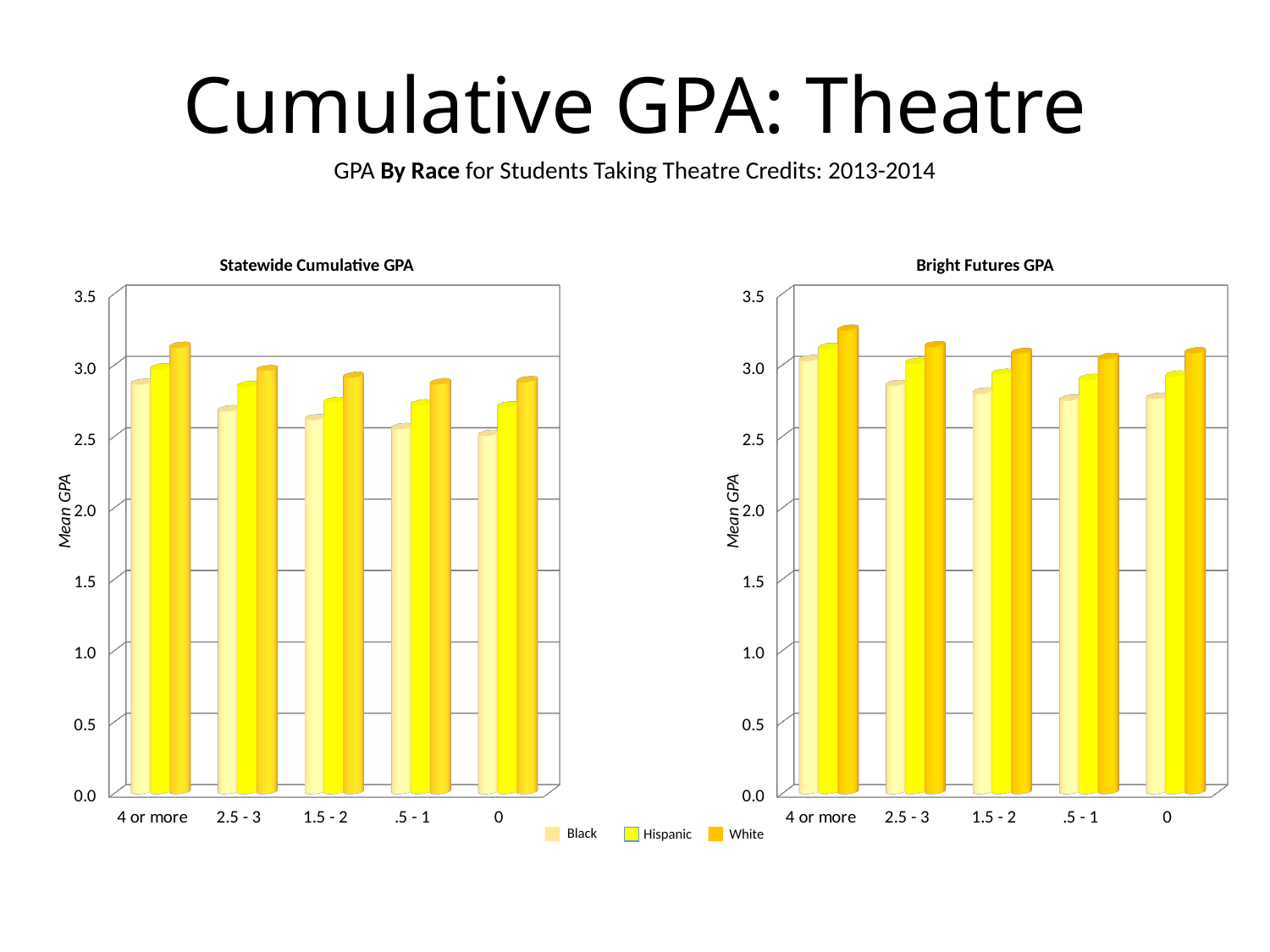
In the Statewide Cumulative GPA chart, do the values for Black students rise or fall from '4 or more' to '0' along the x axis? fall In the Statewide Cumulative GPA chart, which is larger in the '4 or more' category: the value for Black students or for White students? White What kind of chart is the Statewide Cumulative GPA chart? bar chart In the Bright Futures GPA chart, is the value for Black students in the '2.5 - 3' category greater or less than 3.0? less In the Statewide Cumulative GPA chart, is the value for Black students in the '0' category greater or less than 3.0? less How many series does the legend list for the charts on this slide? 3 In the Bright Futures GPA chart, is the value for White students in the '4 or more' category greater or less than 3.0? greater What is the label on the vertical axis of the Bright Futures GPA chart? Mean GPA In the Bright Futures GPA chart, which series has the tallest bar in the '4 or more' category? White In the Statewide Cumulative GPA chart, which category has the highest value for White students? 4 or more How many categories are shown on the x axis of the Bright Futures GPA chart? 5